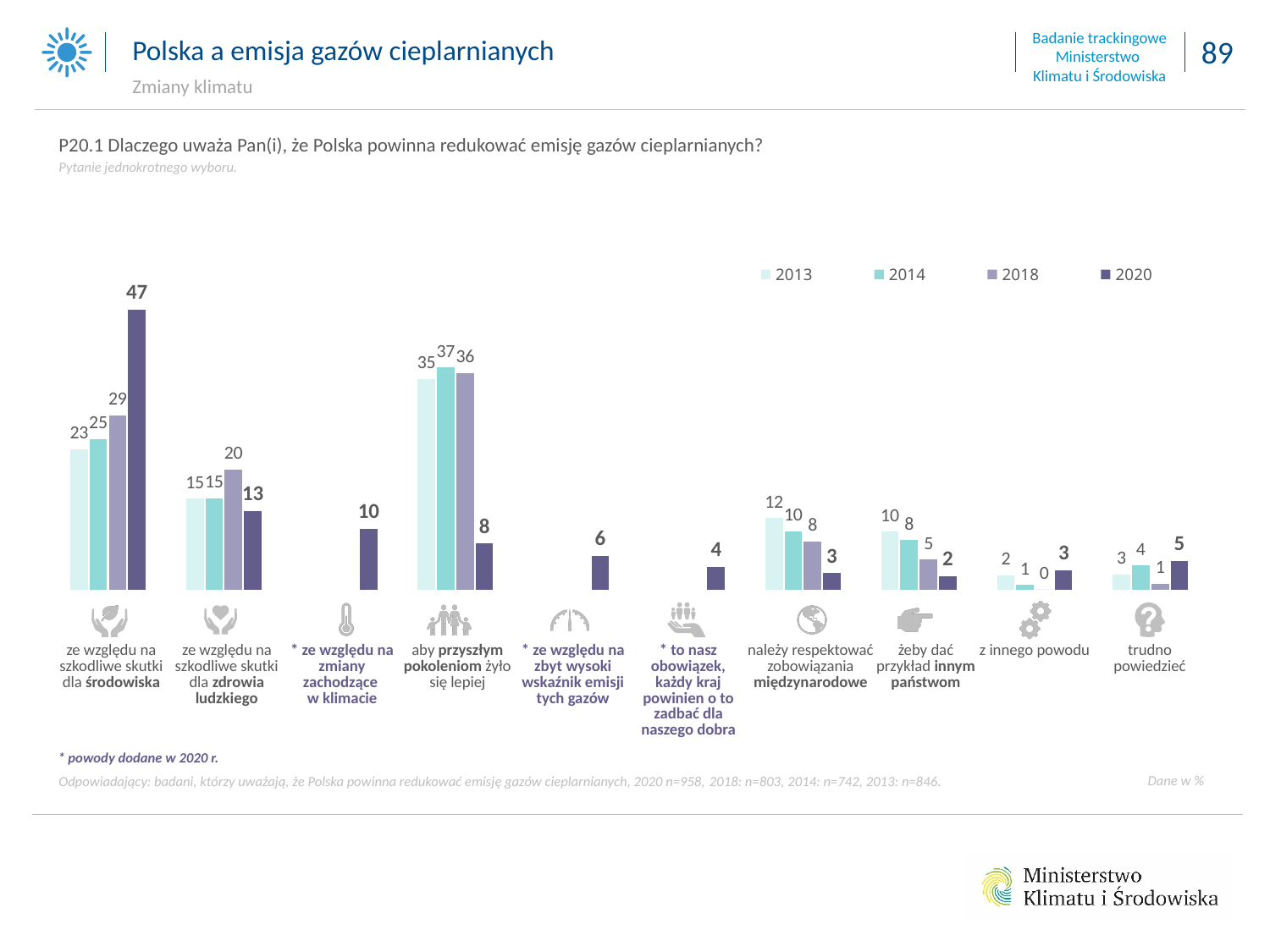
What is the 2020 value for "ze względu na zmiany zachodzące w klimacie"? 10 What is the 2014 value for "aby przyszłym pokoleniom żyło się lepiej"? 37 What is the difference between the 2020 and 2018 values for "ze względu na szkodliwe skutki dla środowiska"? 18 Which category has the highest 2020 value? ze względu na szkodliwe skutki dla środowiska What is the 2018 value for "ze względu na szkodliwe skutki dla zdrowia ludzkiego"? 20 How many categories are shown on the x axis? 10 How many series does the legend list? 4 Which category has the lowest 2018 value? z innego powodu What is the 2020 value for "ze względu na szkodliwe skutki dla środowiska"? 47 What kind of chart is shown on the slide? bar chart Do the values for "należy respektować zobowiązania międzynarodowe" rise or fall from 2013 to 2020? fall Which is larger for "aby przyszłym pokoleniom żyło się lepiej": the 2013 value or the 2020 value? 2013